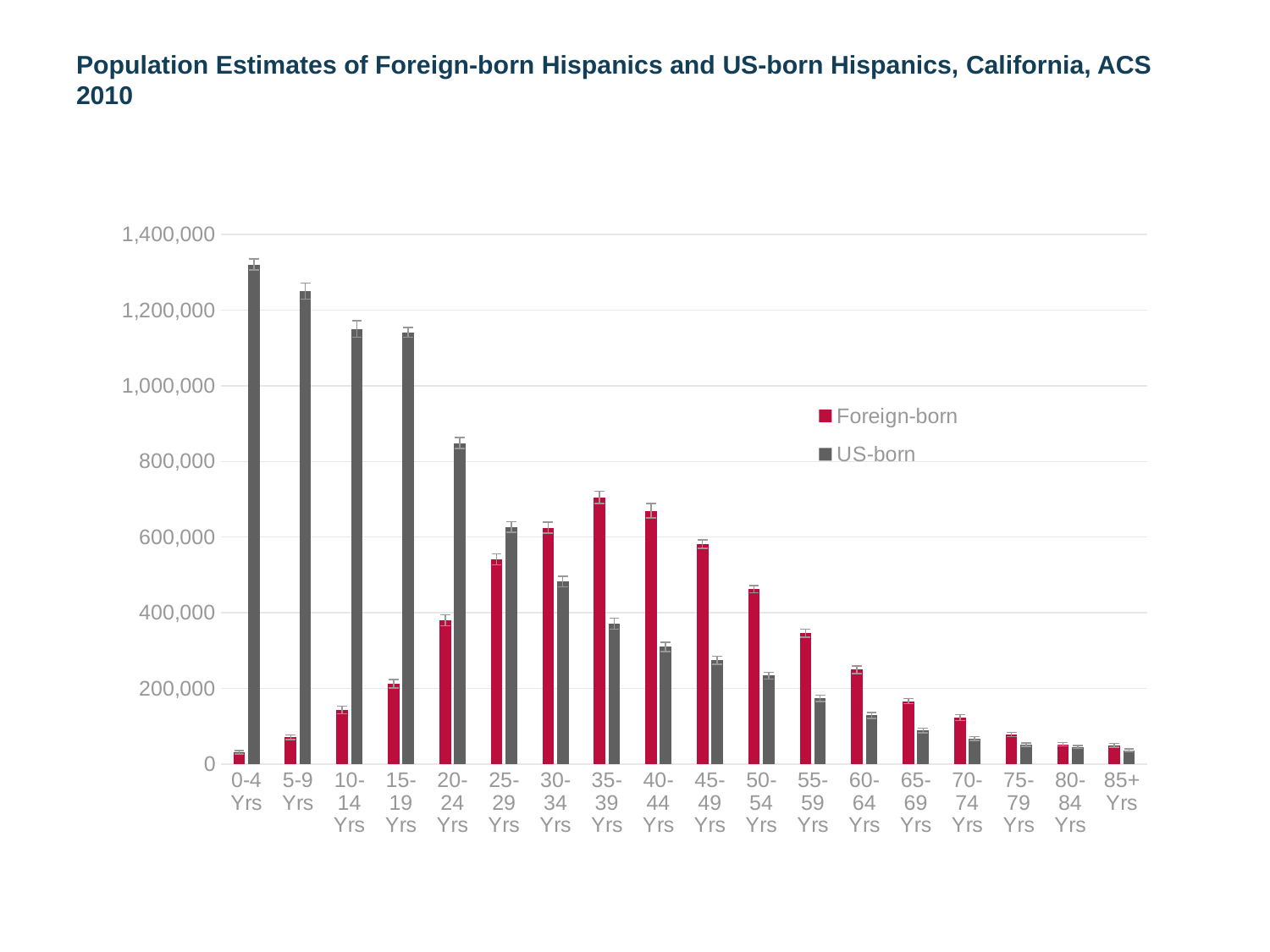
For the 25-29 Yrs age group, which is larger: Foreign-born or US-born? US-born For the 30-34 Yrs age group, which is larger: Foreign-born or US-born? Foreign-born Is the US-born value for 0-4 Yrs greater or less than 1,200,000? greater Which age group has the lowest Foreign-born value? 0-4 Yrs Which colour represents the Foreign-born series in the legend? Red What kind of chart is shown on the slide? Bar chart Is the US-born value for 20-24 Yrs greater or less than 800,000? greater Is the Foreign-born value for 20-24 Yrs greater or less than 400,000? less How many age-group categories are shown on the x axis? 18 How many series does the legend list? 2 Which age group has the highest US-born value? 0-4 Yrs Which age group has the highest Foreign-born value? 35-39 Yrs